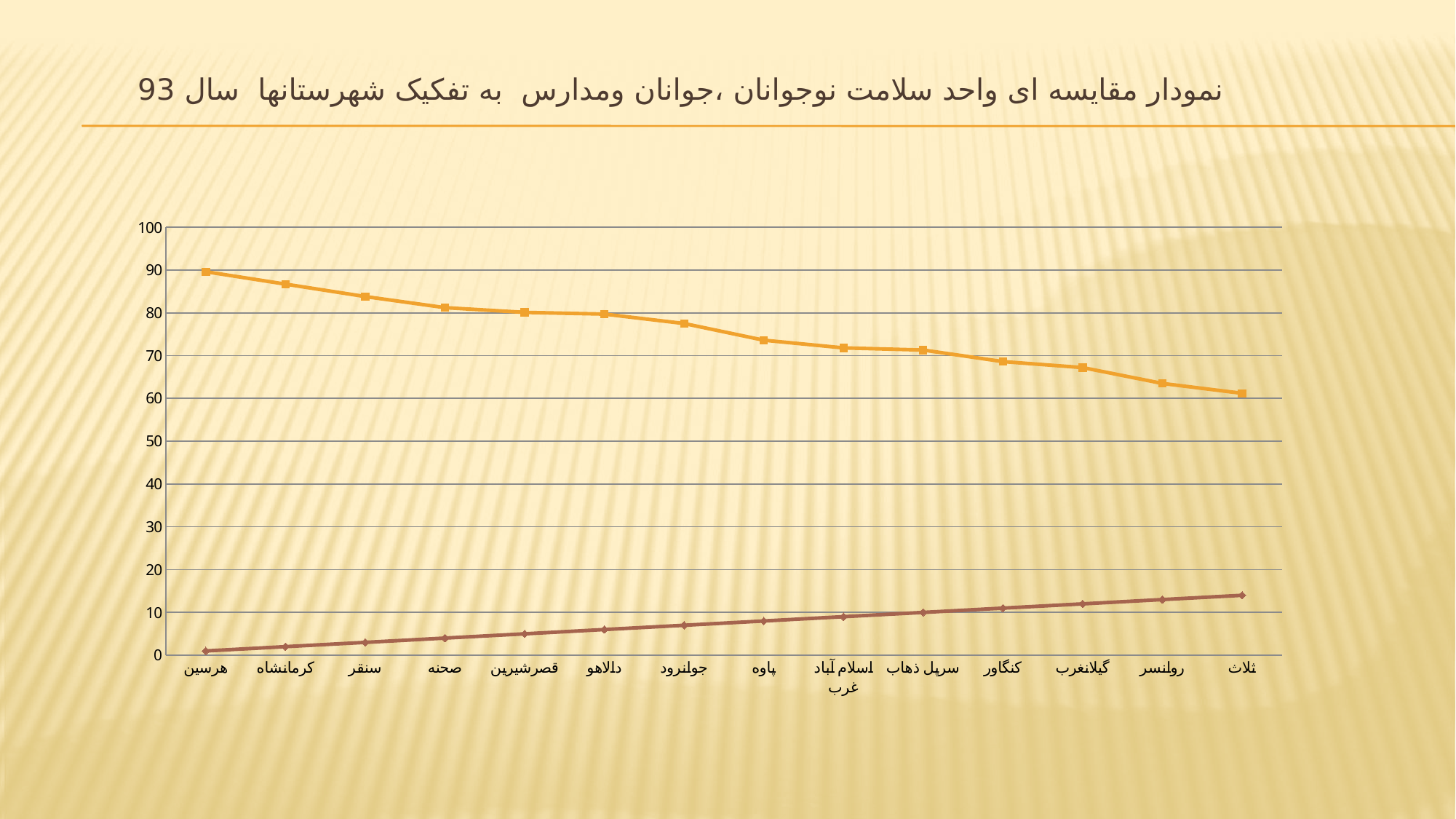
Is the value for روانسر on the orange line greater or less than 70? less Which city has the lowest value on the orange (upper) line? ثلاث What kind of chart is shown on the slide? line chart Which city has the highest value on the brown (lower) line? ثلاث Which year is mentioned in the chart title? 93 How many cities (categories) are shown along the x axis? 14 Does the brown (lower) line rise or fall moving from left to right along the x axis? rise How many data series (lines) are plotted on the chart? 2 Does the orange (upper) line rise or fall moving from left to right along the x axis? fall Is the value for کرمانشاه on the orange line greater or less than 80? greater Which city has the highest value on the orange (upper) line? هرسین On the orange line, which is larger: the value for پاوه or the value for ثلاث? پاوه